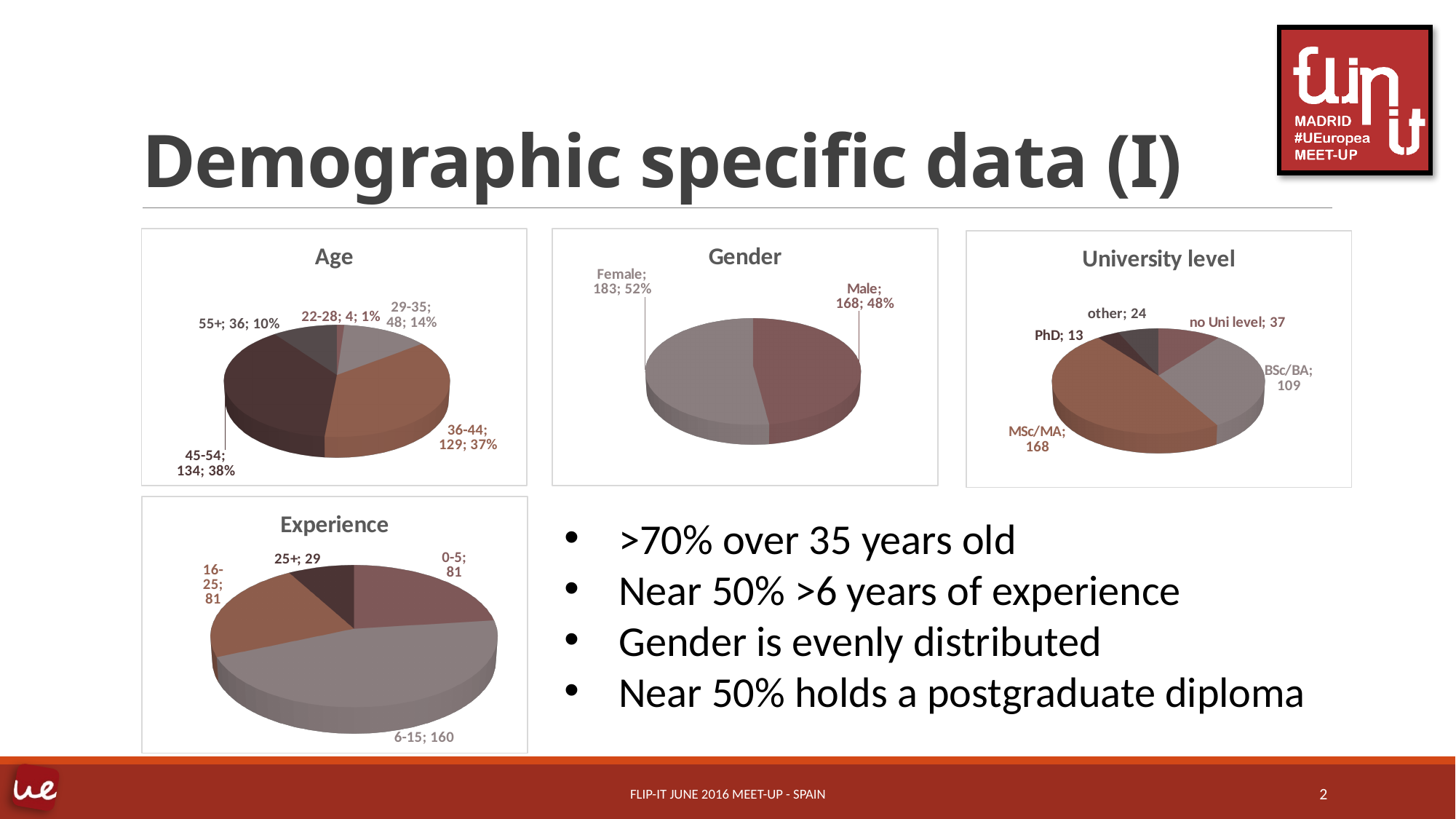
In the Age chart, which age group has the smallest slice? 22-28 In the Experience chart, what is the value for 6-15 years? 160 In the Age chart, how many respondents are in the 45-54 group? 134 In the University level chart, what is the value for PhD? 13 In the Gender chart, how many respondents are Female? 183 In the Age chart, what percentage share does the 36-44 group have? 37% In the Gender chart, what is the difference between the Female and Male counts? 15 What type of chart is the Gender chart? Pie chart In the University level chart, how many categories are shown? 5 In the Experience chart, what is the difference between the 6-15 and 16-25 values? 79 In the University level chart, which category has the largest slice? MSc/MA In the Experience chart, which is larger, 0-5 or 25+? 0-5